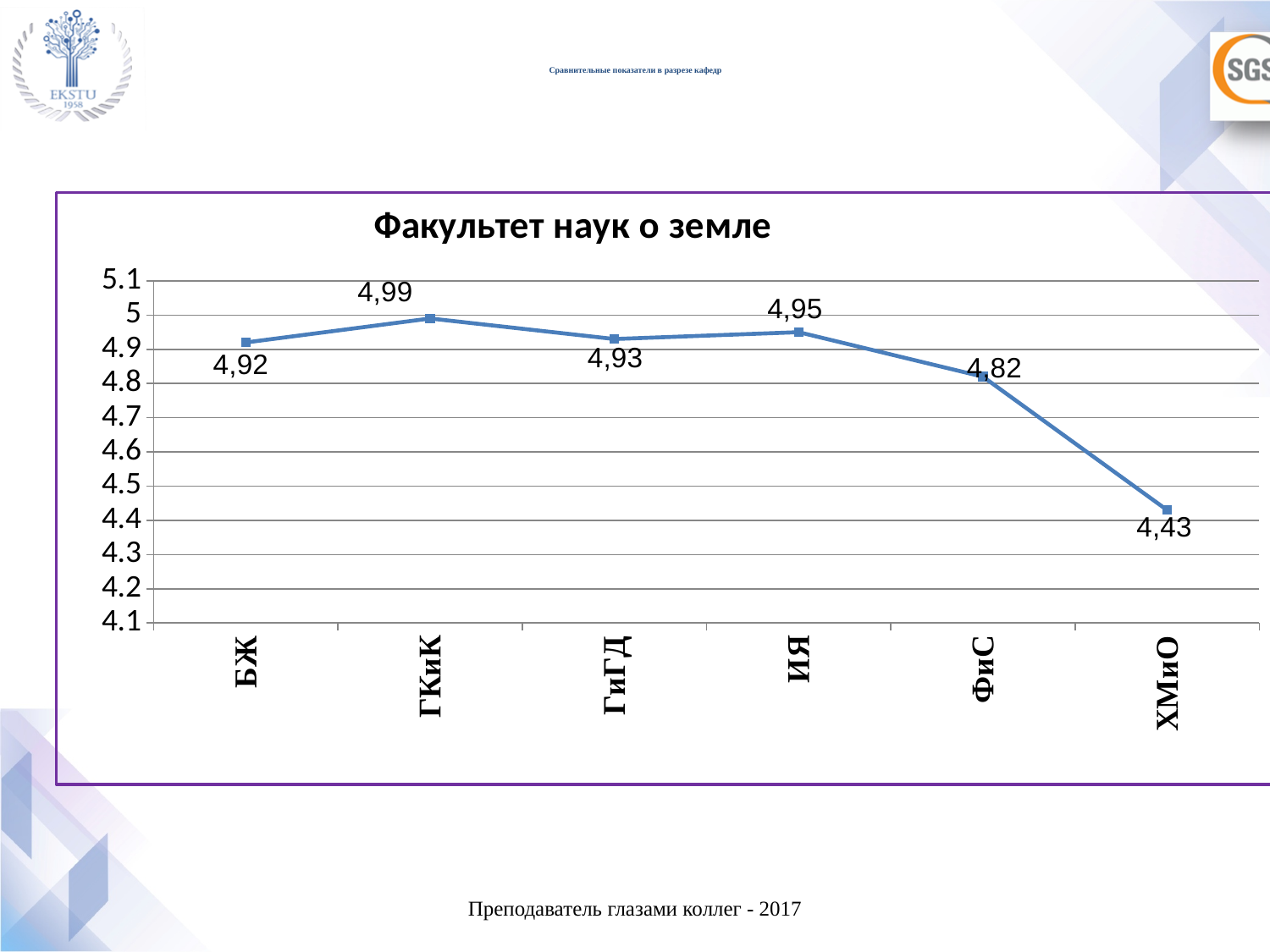
Is the value for ХМиО greater or less than 4.5? less What is the difference between the values for ГКиК and ХМиО? 0,56 What is the value for ГКиК? 4,99 Do the values rise or fall from ФиС to ХМиО? fall What is the title of the chart? Факультет наук о земле What is the value for ФиС? 4,82 What kind of chart is shown? line chart Which category has the lowest value? ХМиО Which category has the highest value? ГКиК Which is larger, the value for ИЯ or the value for ФиС? ИЯ How many categories are plotted on the x axis? 6 What is the value for ХМиО? 4,43